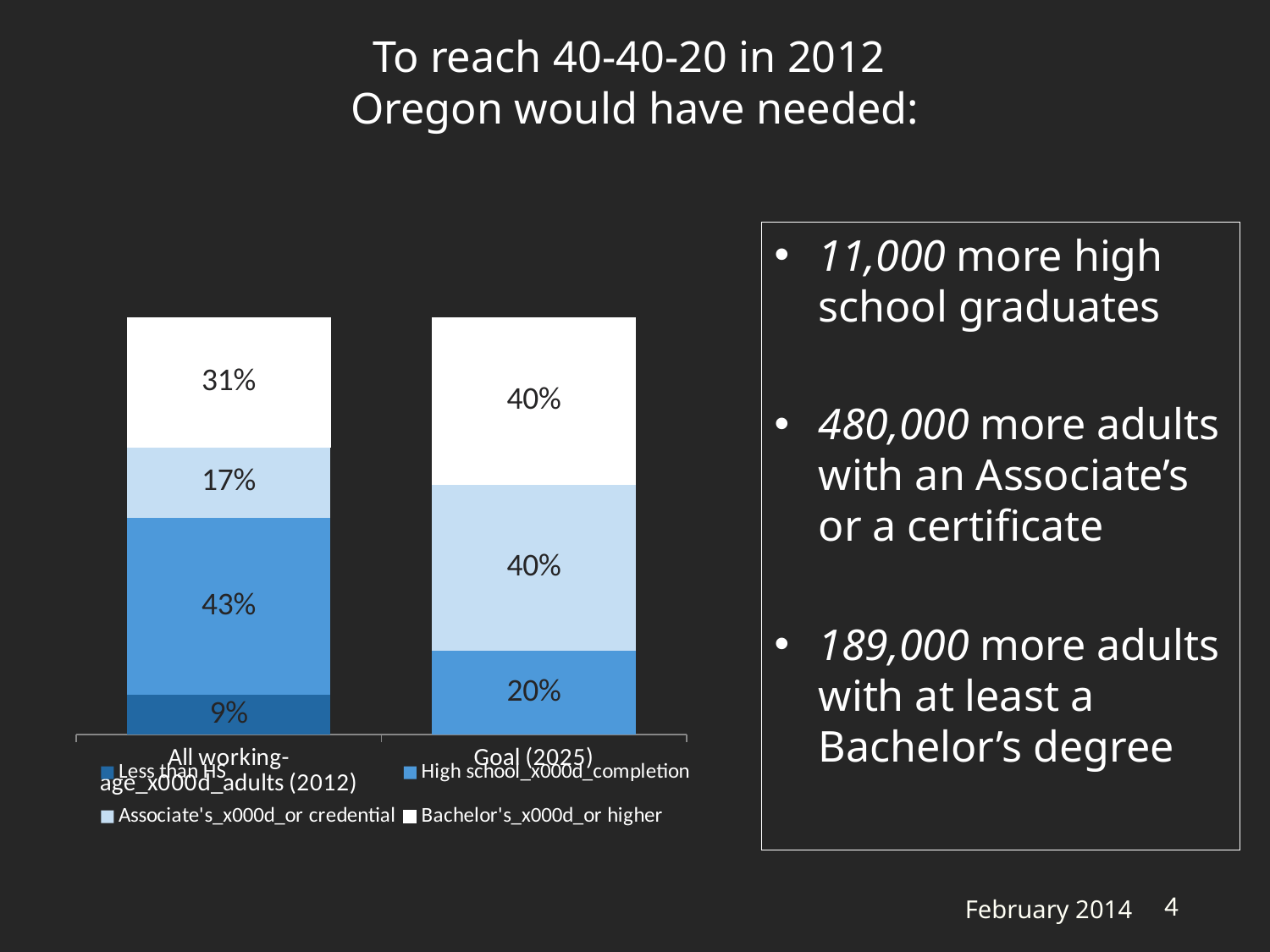
What is the Bachelor's or higher share for All working-age adults (2012)? 31% How many categories (bars) does the chart show? 2 What is the High school completion share for the Goal (2025) bar? 20% What is the difference between the Bachelor's or higher share in the Goal (2025) bar and in the All working-age adults (2012) bar? 9% How many series does the chart legend list? 4 What kind of chart is shown on the slide? Stacked bar chart Which segment is the largest in the All working-age adults (2012) bar? High school completion Which bar has the larger Associate's or credential share, All working-age adults (2012) or Goal (2025)? Goal (2025) What is the Less than HS share for All working-age adults (2012)? 9% What is the High school completion share for All working-age adults (2012)? 43% Which segment is the smallest in the All working-age adults (2012) bar? Less than HS What is the Associate's or credential share for the Goal (2025) bar? 40%